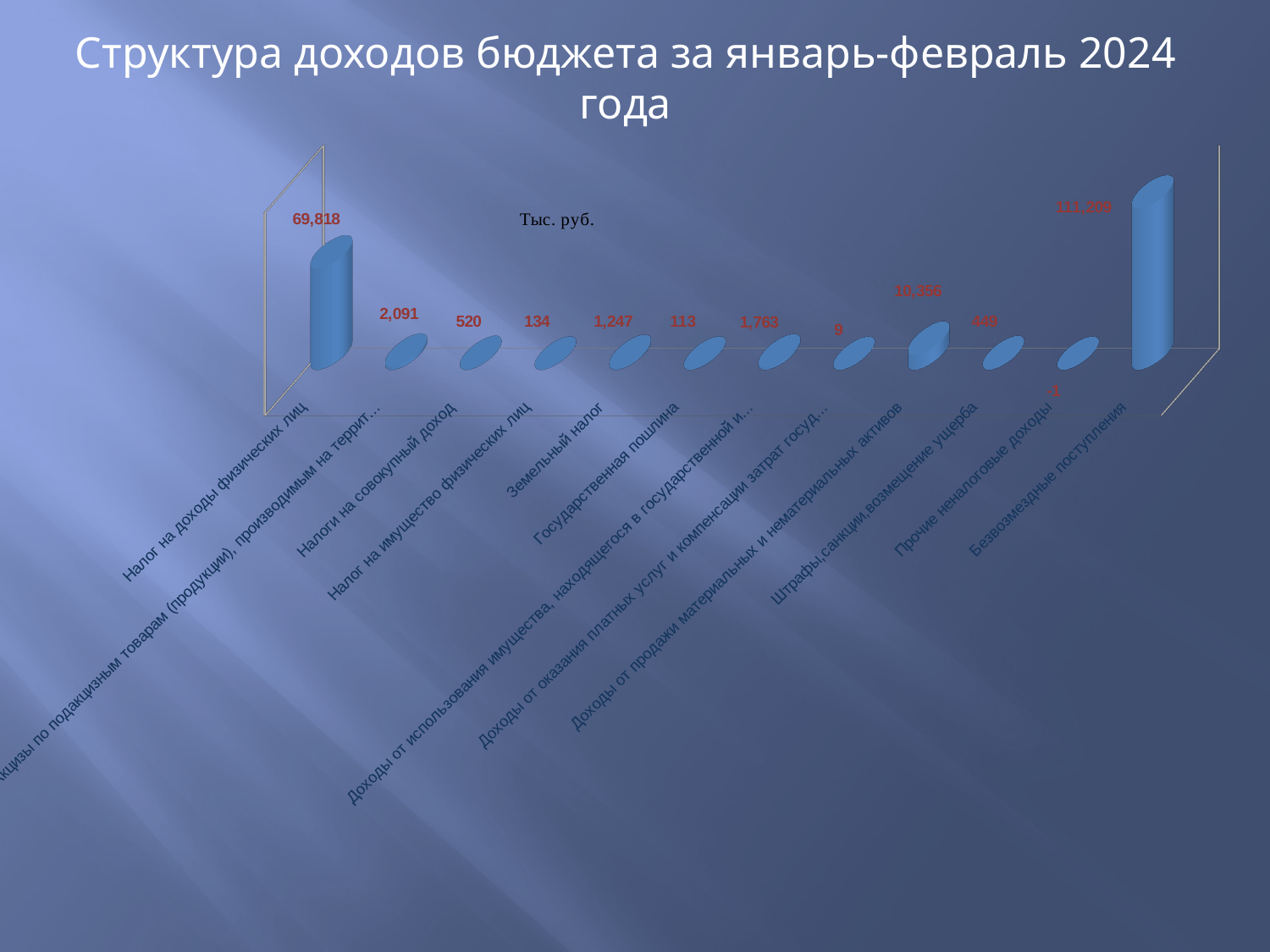
What kind of chart is shown on the slide? Bar chart What is the value for Налог на доходы физических лиц? 69,818 Which category has the highest value? Безвозмездные поступления What is the difference between the values for Налог на доходы физических лиц and Налог на имущество физических лиц? 69,684 Which is larger, the value for Земельный налог or the value for Налоги на совокупный доход? Земельный налог Which category has the lowest value? Прочие неналоговые доходы How many categories are shown on the chart? 12 What is the value for Налоги на совокупный доход? 520 What is the value for Прочие неналоговые доходы? -1 What is the value for Государственная пошлина? 113 What unit is indicated on the chart? Тыс. руб. What is the value for Земельный налог? 1,247